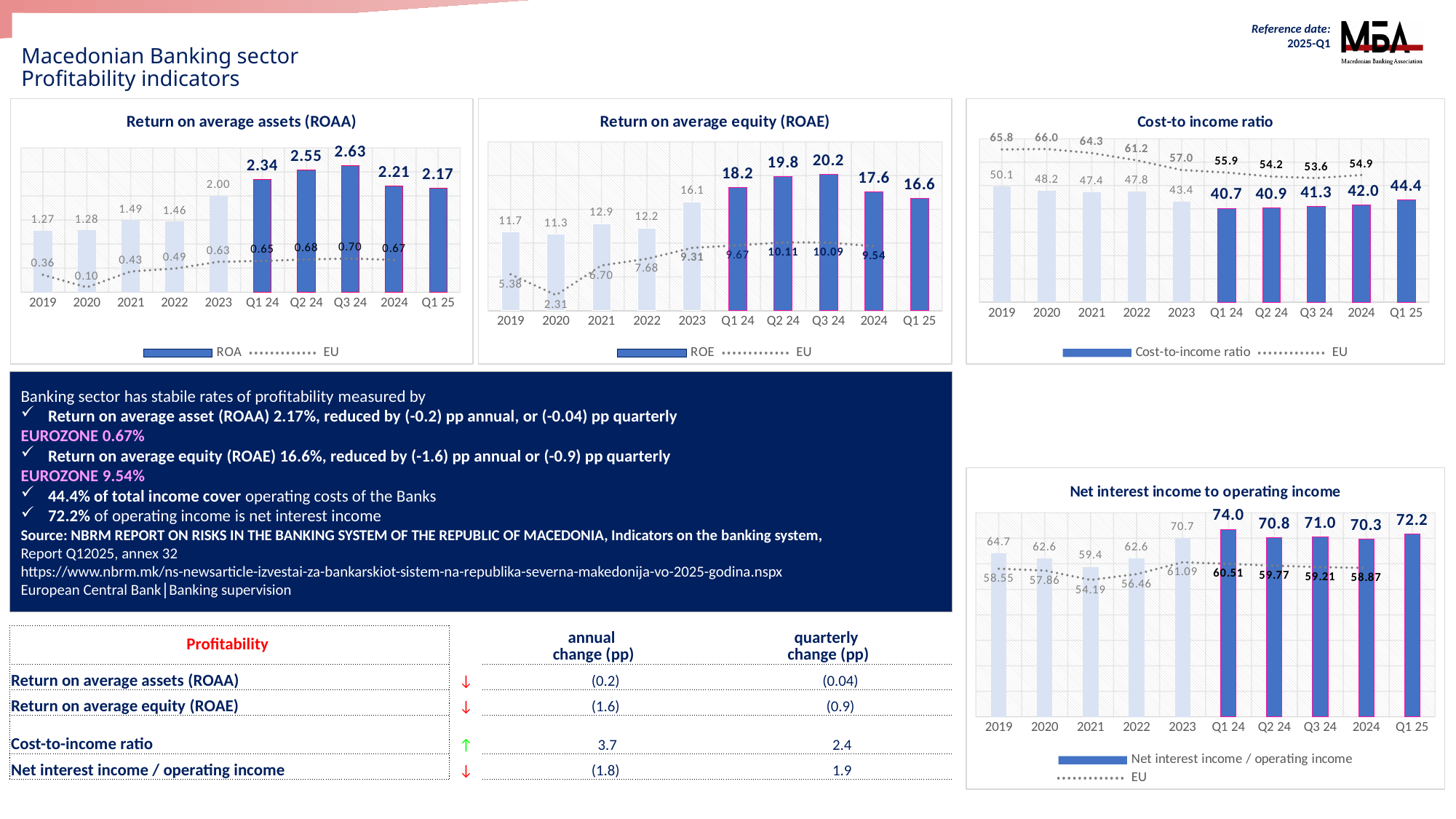
In the Cost-to income ratio chart, how many periods are shown on the x axis? 10 In the Return on average equity (ROAE) chart, how many series does the legend list? 2 In the Return on average assets (ROAA) chart, which period has the highest ROA bar? Q3 24 In the Net interest income to operating income chart, which period has the highest bar? Q1 24 What kind of chart is the Net interest income to operating income chart? Bar chart with a line In the Return on average equity (ROAE) chart, what is the difference between the ROE values for Q3 24 and Q1 25? 3.6 In the Return on average assets (ROAA) chart, what is the ROA value for Q1 25? 2.17 In the Cost-to income ratio chart, which is larger for 2024: the Cost-to-income ratio or the EU value? EU In the Return on average equity (ROAE) chart, which period has the lowest EU value? 2020 In the Cost-to income ratio chart, what is the Cost-to-income ratio value for Q1 24? 40.7 In the Return on average assets (ROAA) chart, what is the EU value for 2020? 0.10 In the Net interest income to operating income chart, what is the EU value for 2021? 54.19